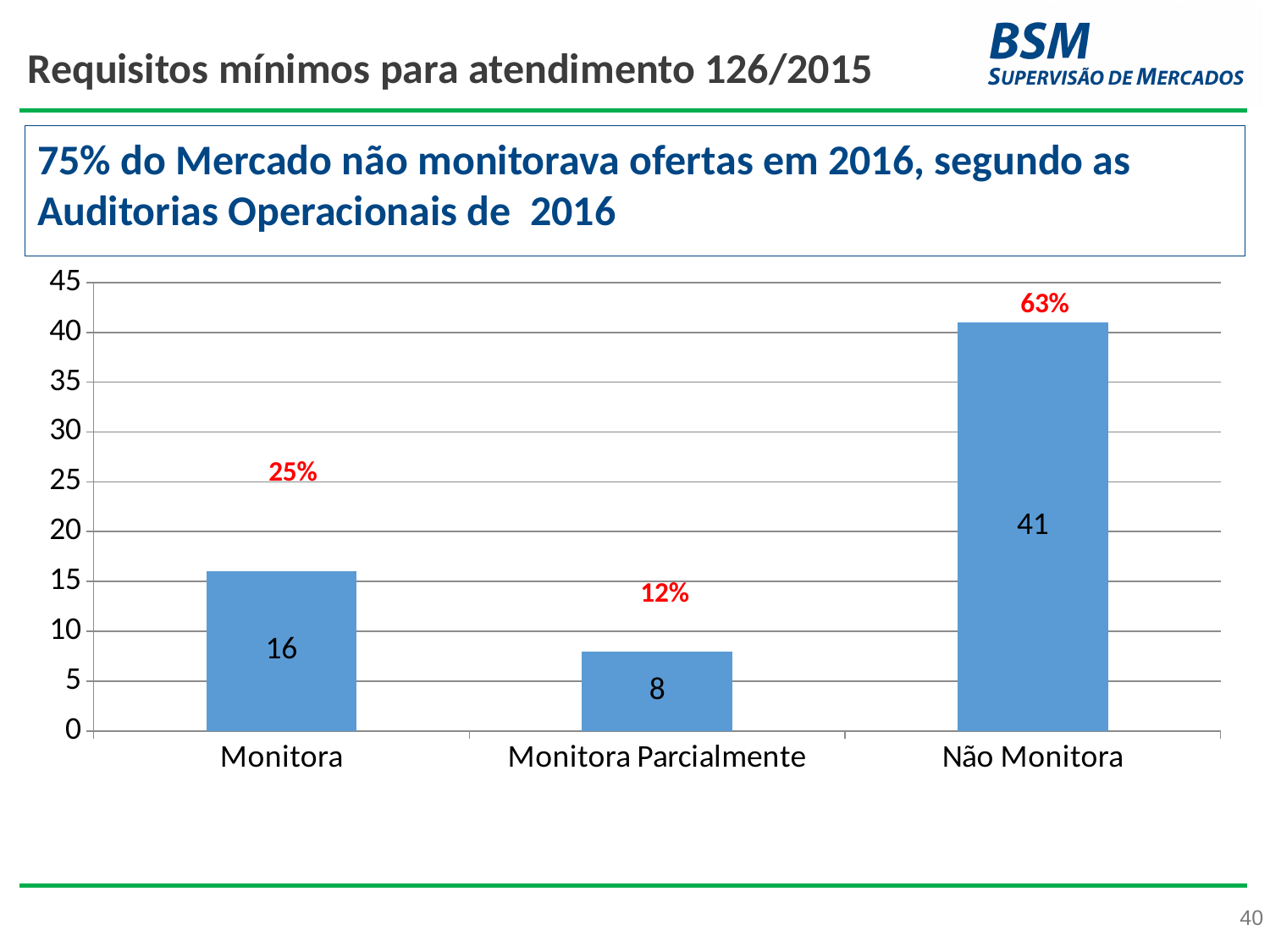
What percentage label is shown above the Não Monitora bar? 63% How many categories are shown on the x axis? 3 Which category has the highest value? Não Monitora What is the difference between the values for Não Monitora and Monitora? 25 What kind of chart is shown on the slide? Bar chart What is the value for Não Monitora? 41 What is the value for Monitora? 16 Which category has the lowest value? Monitora Parcialmente What percentage label is shown above the Monitora bar? 25% What is the value for Monitora Parcialmente? 8 Is the value for Não Monitora greater or less than 35? greater Which is larger, the value for Monitora or the value for Monitora Parcialmente? Monitora